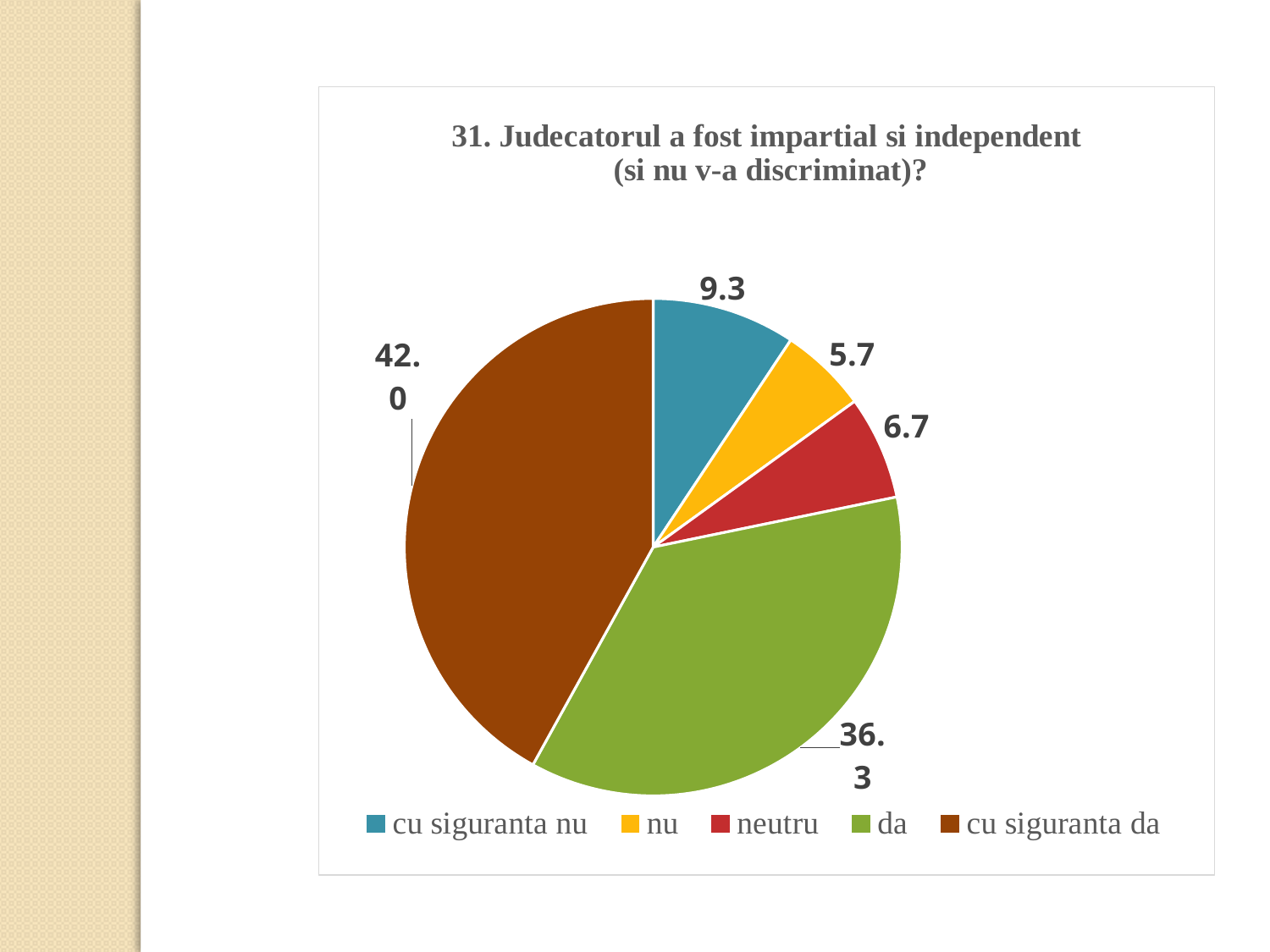
Which is larger, the value for "neutru" or the value for "nu"? neutru What is the value for "cu siguranta da"? 42.0 Which category has the smallest slice? nu Which category has the largest slice? cu siguranta da What type of chart is shown on the slide? pie chart What is the value for "neutru"? 6.7 How many categories does the legend list? 5 What is the value for "da"? 36.3 What is the difference between the values for "cu siguranta da" and "da"? 5.7 What colour is the slice for "da"? green What is the value for "nu"? 5.7 What is the value for "cu siguranta nu"? 9.3